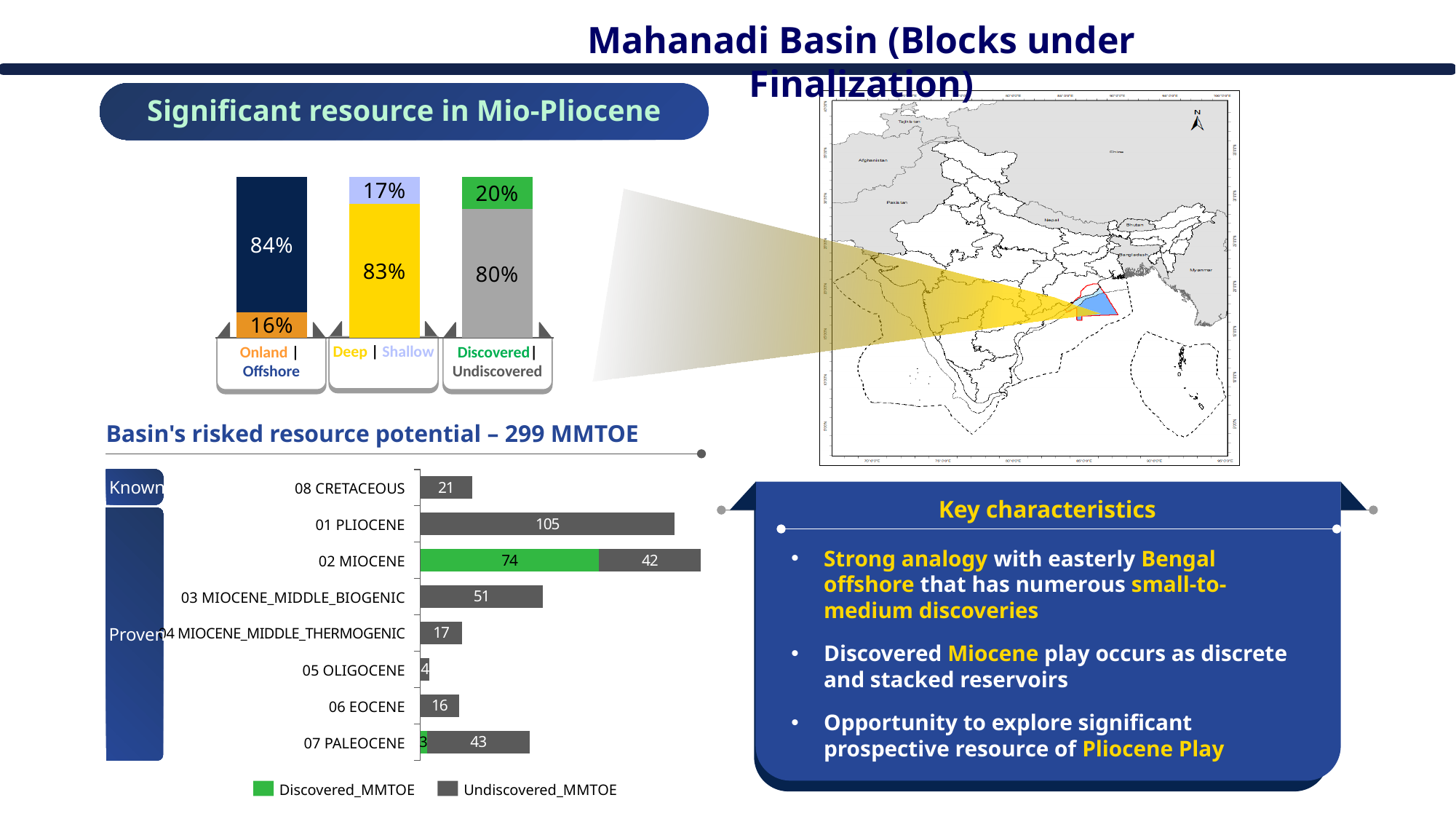
In the 'Basin's risked resource potential – 299 MMTOE' chart, how many categories are plotted? 8 In the 'Basin's risked resource potential – 299 MMTOE' chart, how many series does the legend list? 2 In the 'Basin's risked resource potential – 299 MMTOE' chart, what is the Undiscovered_MMTOE value for 01 PLIOCENE? 105 In the 'Basin's risked resource potential – 299 MMTOE' chart, what is the Undiscovered_MMTOE value for 03 MIOCENE_MIDDLE_BIOGENIC? 51 What kind of chart is 'Basin's risked resource potential – 299 MMTOE'? Stacked bar chart In the 'Basin's risked resource potential – 299 MMTOE' chart, what is the difference between the Undiscovered_MMTOE values for 01 PLIOCENE and 08 CRETACEOUS? 84 In the 'Basin's risked resource potential – 299 MMTOE' chart, which category has the lowest Undiscovered_MMTOE value? 05 OLIGOCENE In the stacked bar chart under 'Significant resource in Mio-Pliocene', which is larger, the Deep share or the Shallow share? Deep In the stacked bar chart under 'Significant resource in Mio-Pliocene', what percentage is shown for Offshore? 84% In the 'Basin's risked resource potential – 299 MMTOE' chart, what is the Discovered_MMTOE value for 02 MIOCENE? 74 In the 'Basin's risked resource potential – 299 MMTOE' chart, what is the total of the stacked bar for 07 PALEOCENE? 45 In the 'Basin's risked resource potential – 299 MMTOE' chart, what is the total of the stacked bar for 02 MIOCENE? 116